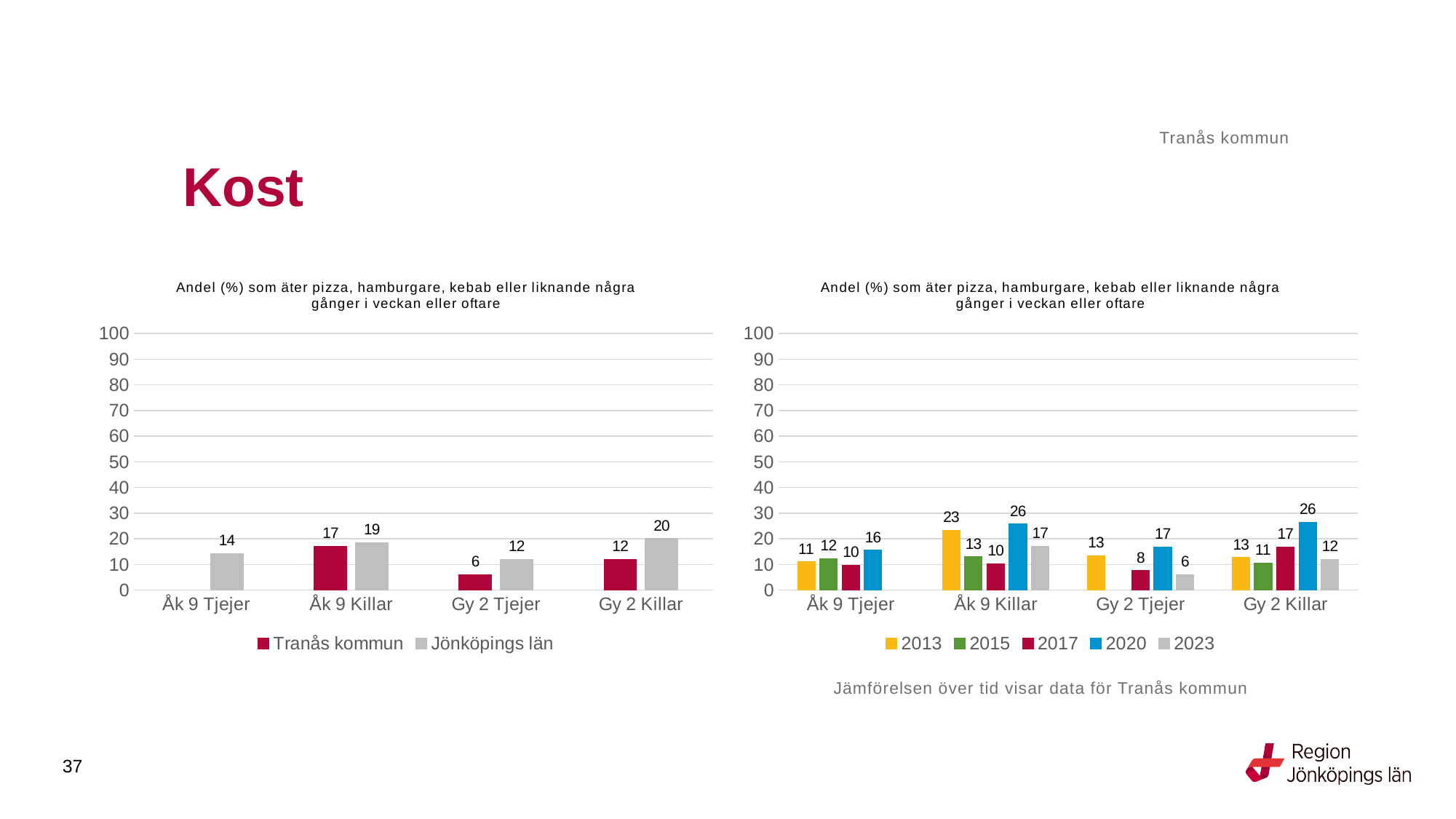
In the left chart, what is the difference between Jönköpings län and Tranås kommun for Åk 9 Killar? 2 In the left chart, how many series does the legend list? 2 In the left chart, which category has the highest value for Jönköpings län? Gy 2 Killar In the right chart, which year has the lowest value for Gy 2 Killar? 2015 In the right chart, how many series does the legend list? 5 What kind of chart is the right chart? Bar chart In the right chart, is the value for 2013 or 2017 larger for Åk 9 Killar? 2013 In the right chart, what is the difference between 2020 and 2017 for Gy 2 Tjejer? 9 In the right chart, what is the value for 2023 for Gy 2 Tjejer? 6 In the left chart, what is the value for Jönköpings län for Gy 2 Killar? 20 In the right chart, what is the value for 2020 for Åk 9 Killar? 26 In the left chart, what is the value for Tranås kommun for Gy 2 Tjejer? 6